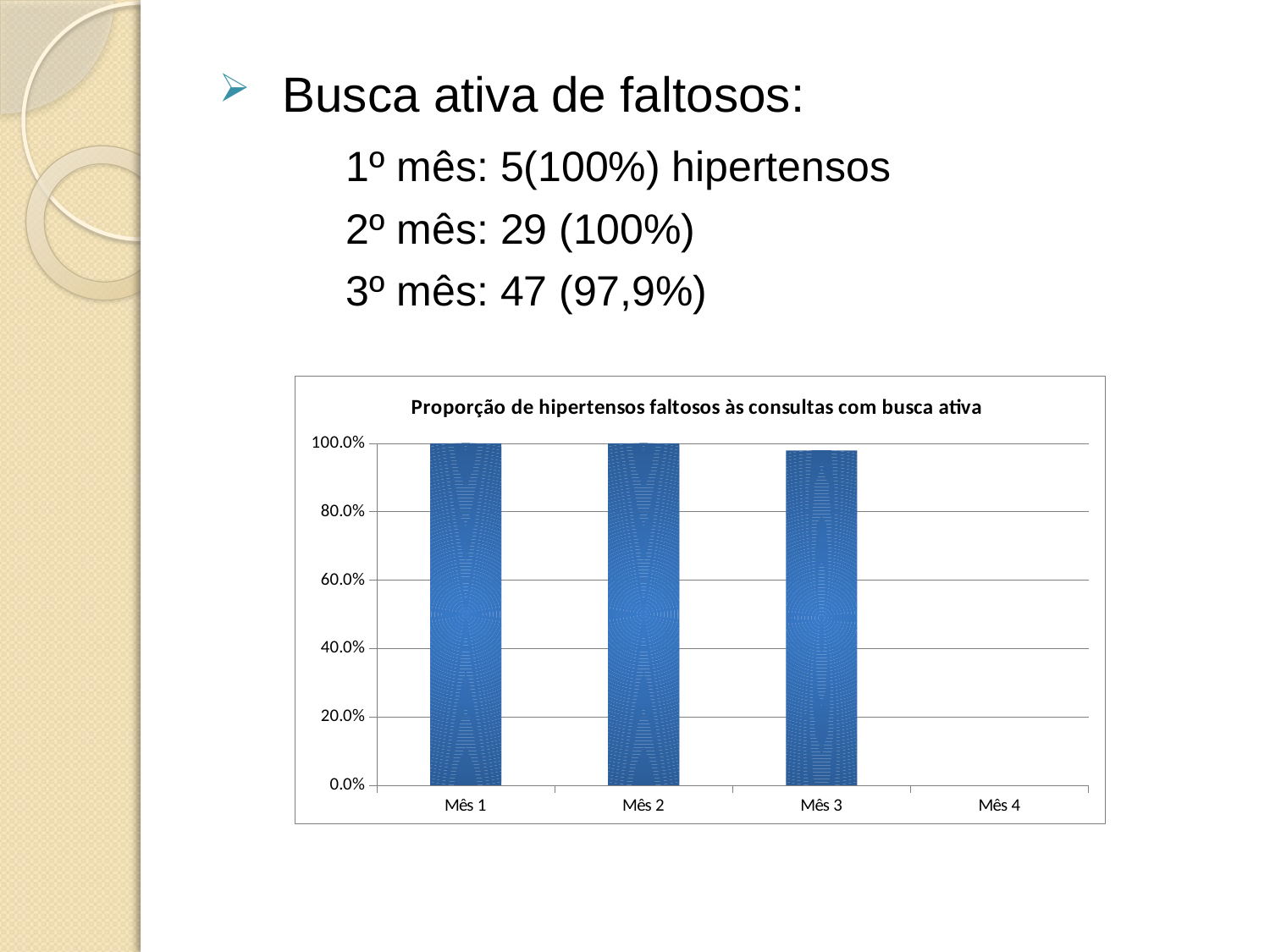
What is the value for Mês 1 in the chart? 100.0% Is the value for Mês 3 greater or less than 80.0%? greater Which category on the x axis has no bar plotted? Mês 4 What is the value for Mês 2 in the chart? 100.0% How many categories are shown on the x axis of the chart? 4 Which is larger, the value for Mês 1 or the value for Mês 3? Mês 1 What is the title of the chart? Proporção de hipertensos faltosos às consultas com busca ativa Is the value for Mês 1 greater or less than 60.0%? greater What is the highest value shown on the y axis of the chart? 100.0% What type of chart is shown on the slide? bar chart